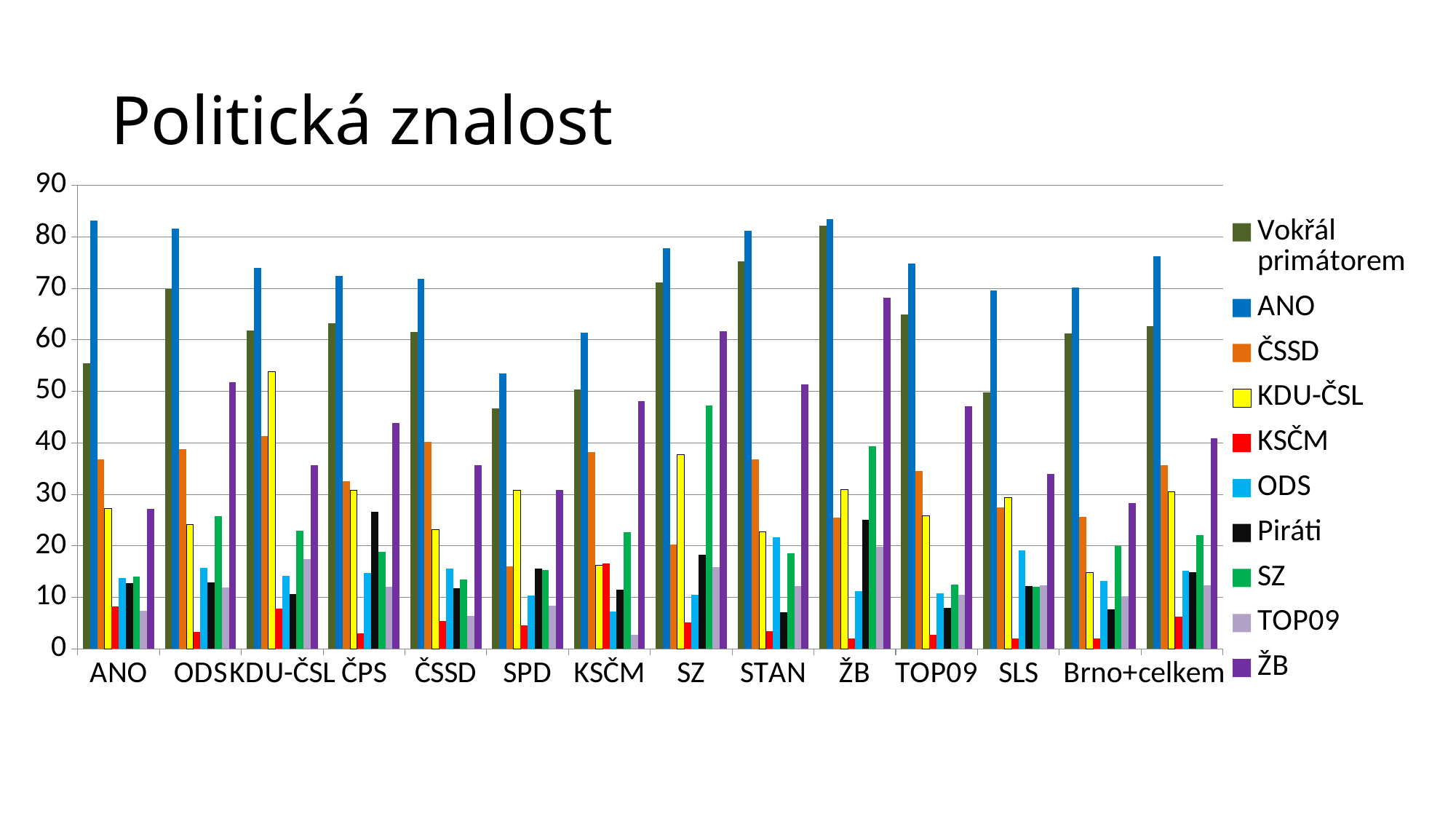
What kind of chart is shown on the slide? bar chart In the ANO category, which is larger: the ANO series or the ČSSD series? ANO How many series does the legend of the chart list? 10 In the ŽB category, which series has the lowest value? KSČM Is the value of the ŽB series for the ŽB category greater or less than 60? greater What is the title of the chart? Politická znalost For the Vokřál primátorem series, which category has the larger value: ANO or ODS? ODS In the SZ category, which series has the highest value? ANO How many categories are shown along the x axis of the chart? 14 Is the value of the KDU-ČSL series for the KDU-ČSL category greater or less than 50? greater Is the value of the KSČM series for the ODS category greater or less than 10? less